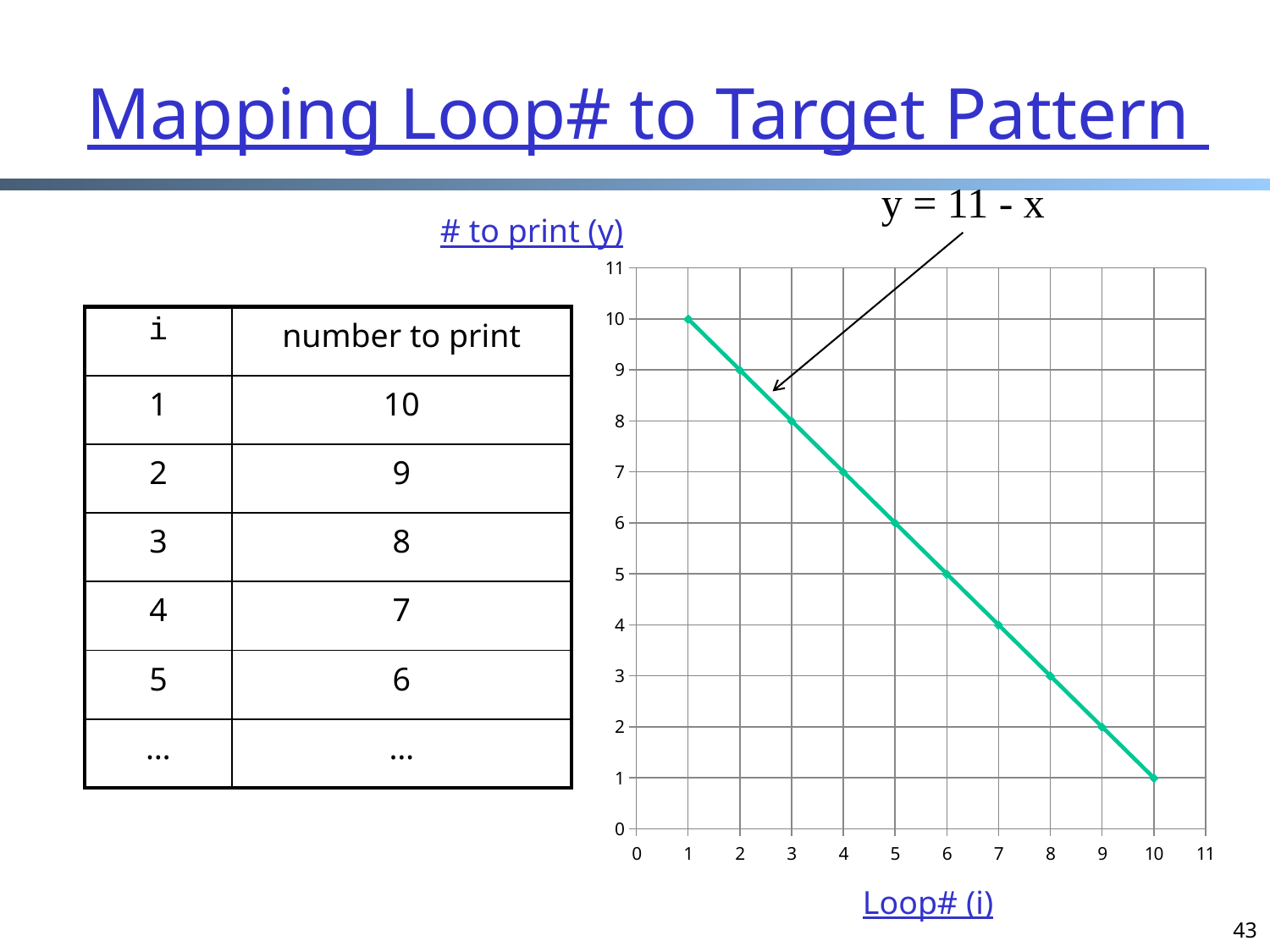
Do the y values rise or fall as the loop number (i) increases along the x axis? fall What kind of chart is shown on the slide? line chart What is the value of y when the loop number (i) is 10? 1 What is the difference between the y value at i = 1 and the y value at i = 10? 9 What equation is written above the chart to describe the plotted line? y = 11 - x At which loop number (i) is the plotted y value lowest? 10 What is the value of y when the loop number (i) is 7? 4 What is the value of y when the loop number (i) is 1? 10 What is the value of y when the loop number (i) is 5? 6 Which is larger: the y value at i = 3 or the y value at i = 8? i = 3 At which loop number (i) is the plotted y value highest? 1 How many data points are plotted on the chart? 10